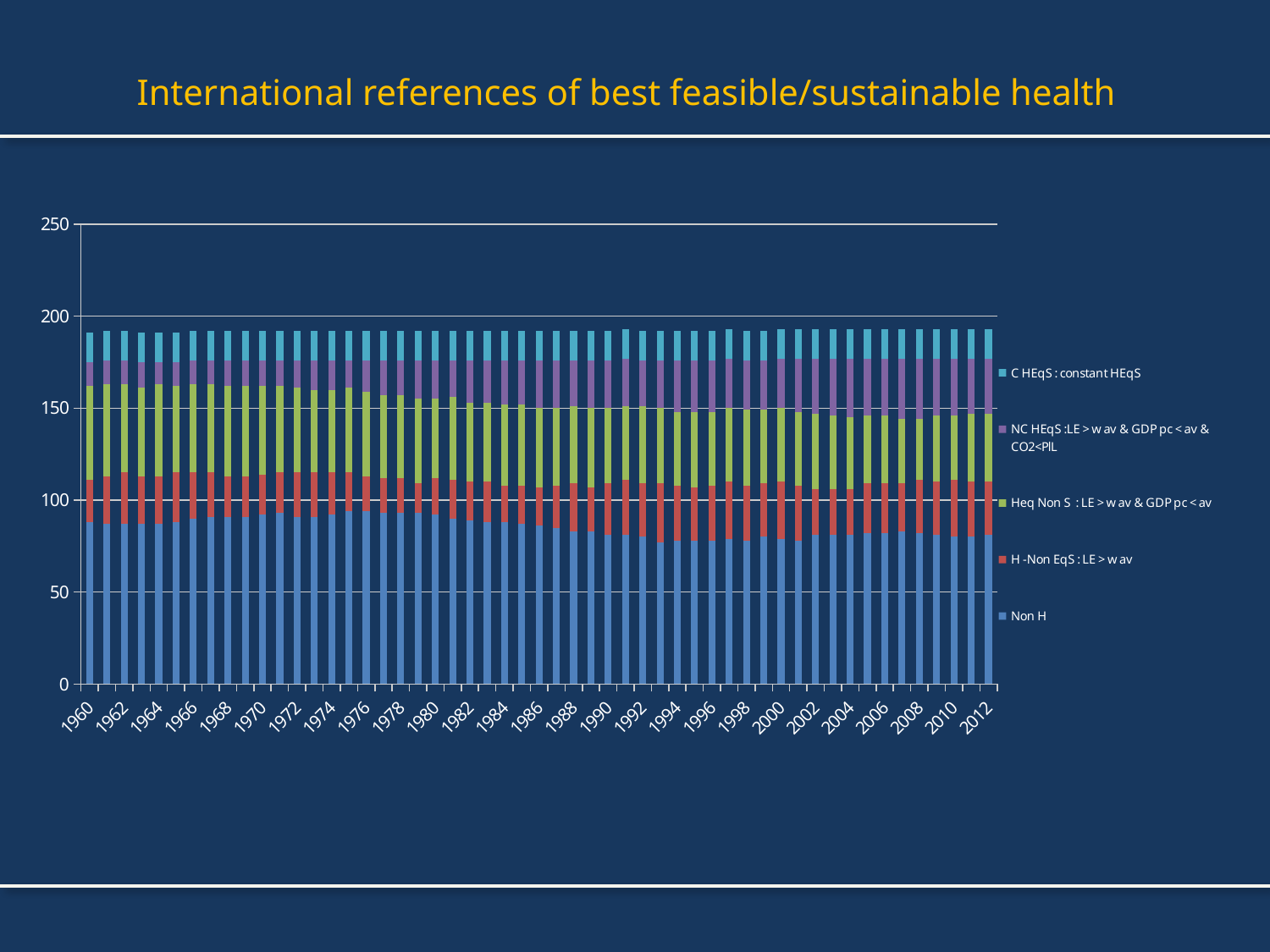
How many years (bars) are plotted on the x axis, from 1960 to 2012? 53 Is the value of the Non H segment for 1970 greater or less than 50? greater Is the total height of the stacked bar for 2012 greater or less than 150? greater Is the value of the Non H segment for 1960 greater or less than 100? less How many series does the legend list? 5 What is the title of the slide containing the chart? International references of best feasible/sustainable health Which series is listed first (at the top) in the legend? C HEqS : constant HEqS Does the Non H segment generally rise or fall from 1960 to 2012? fall What kind of chart is shown on the slide? stacked bar chart